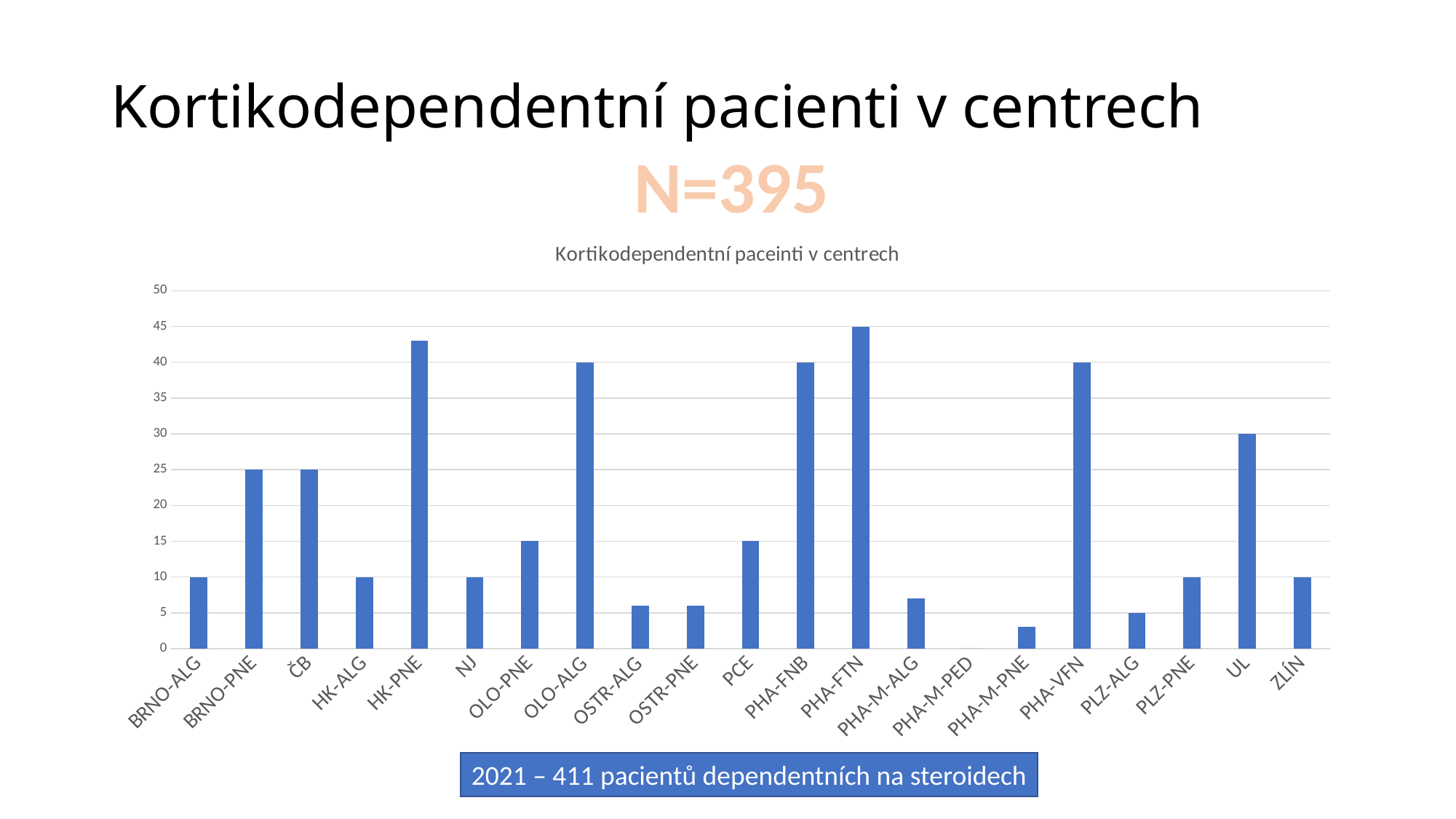
What is the difference between the values for PHA-FTN and UL? 15 Which is larger, the value for UL or the value for PCE? UL What kind of chart is shown on the slide? bar chart Which centre has the lowest value? PHA-M-PED What is the value for UL? 30 What is the value for BRNO-PNE? 25 Which centre has the highest value? PHA-FTN How many centres are shown on the x axis? 21 What is the value for PHA-FTN? 45 What is the value for OLO-ALG? 40 Is the value for HK-PNE greater or less than 40? greater Is the value for PHA-M-PNE greater or less than 5? less